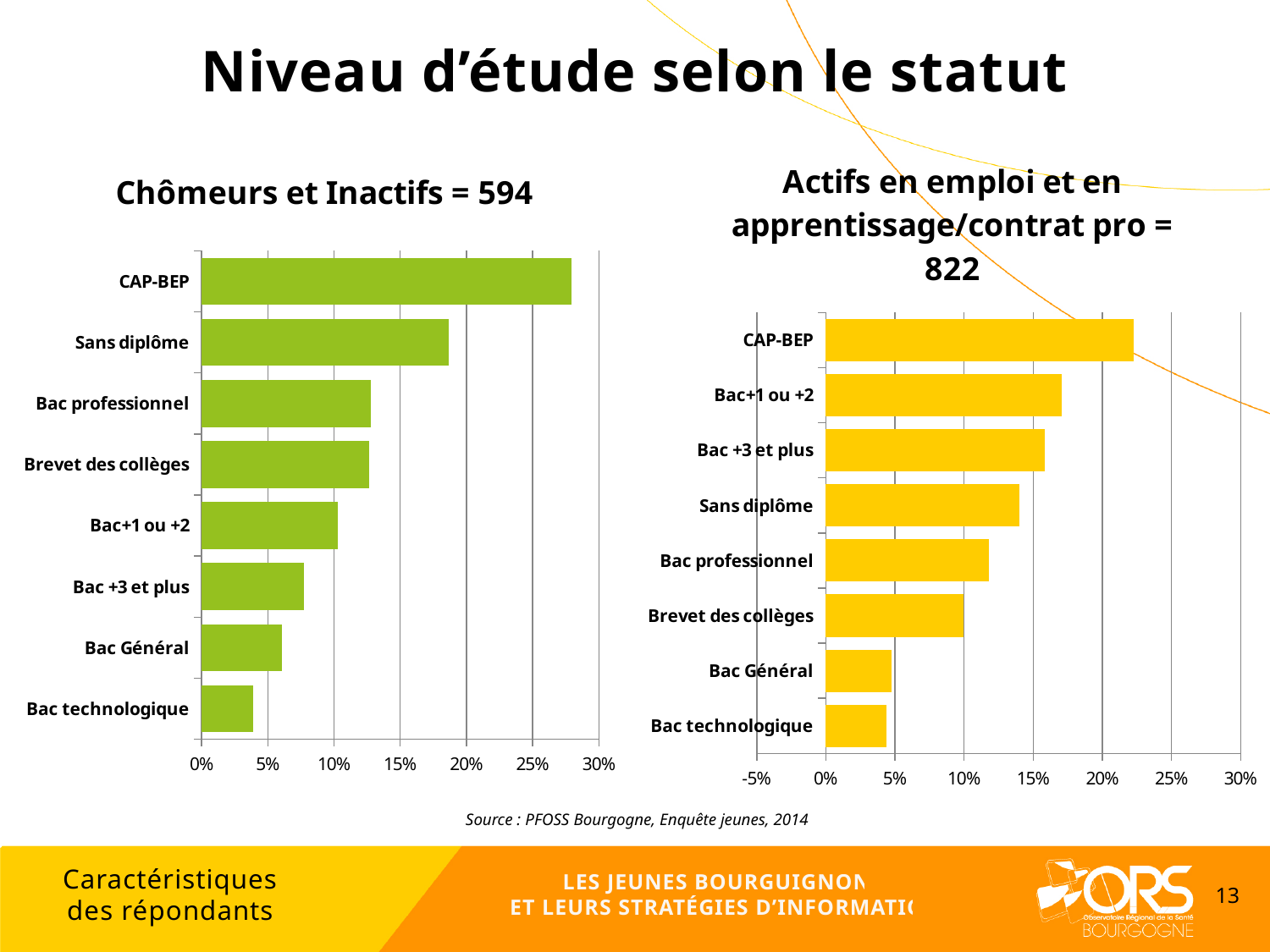
In the 'Chômeurs et Inactifs = 594' chart, which category has the lowest value? Bac technologique In the 'Chômeurs et Inactifs = 594' chart, which is larger, the value for Sans diplôme or the value for Bac+1 ou +2? Sans diplôme In the 'Actifs en emploi et en apprentissage/contrat pro = 822' chart, which is larger, the value for Bac+1 ou +2 or the value for Bac professionnel? Bac+1 ou +2 How many categories are shown in the 'Chômeurs et Inactifs = 594' chart? 8 In the 'Chômeurs et Inactifs = 594' chart, which category has the highest value? CAP-BEP In the 'Actifs en emploi et en apprentissage/contrat pro = 822' chart, is the value for CAP-BEP greater or less than 20%? greater What kind of chart is the 'Chômeurs et Inactifs = 594' chart? Bar chart In the 'Actifs en emploi et en apprentissage/contrat pro = 822' chart, is the value for Brevet des collèges greater or less than 15%? less In the 'Actifs en emploi et en apprentissage/contrat pro = 822' chart, which category has the highest value? CAP-BEP In the 'Chômeurs et Inactifs = 594' chart, is the value for CAP-BEP greater or less than 25%? greater What is the title of the chart on the left of the slide? Chômeurs et Inactifs = 594